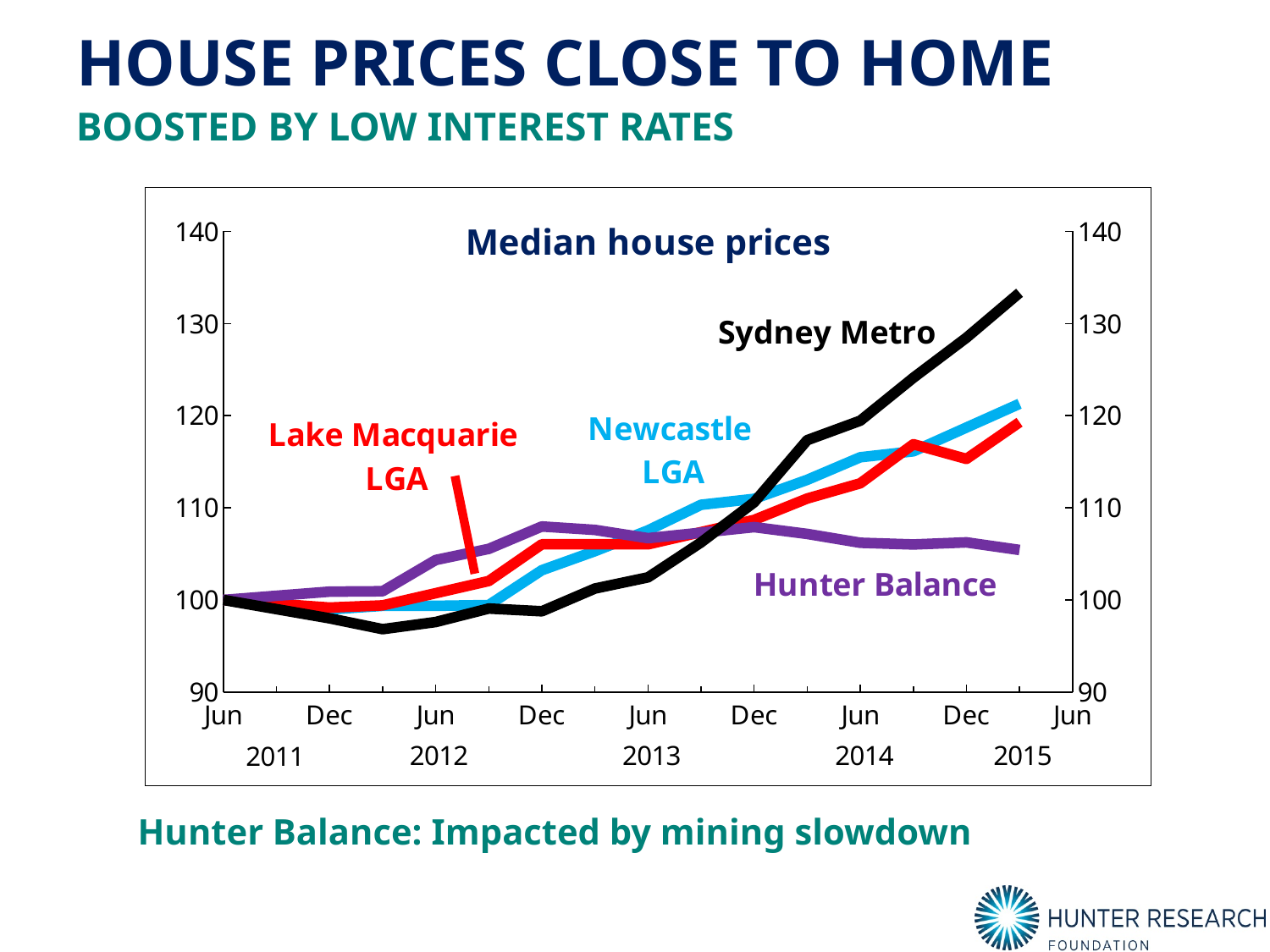
At the end of the chart, which is larger: Sydney Metro or Hunter Balance? Sydney Metro Which series has the highest value at the end of the chart (2015)? Sydney Metro What value do all four series start at in Jun 2011? 100 Is the value for Sydney Metro at the end of the chart greater or less than 130? greater What is the title of the chart? Median house prices Is the value for Hunter Balance at the end of the chart greater or less than 110? less How many series are plotted on the chart? 4 What colour is the Sydney Metro line? black Is the value for Sydney Metro in Jun 2014 greater or less than 110? greater Does the Sydney Metro series rise or fall overall from Jun 2011 to 2015? rise Which series has the lowest value at the end of the chart (2015)? Hunter Balance What type of chart is shown on the slide? line chart